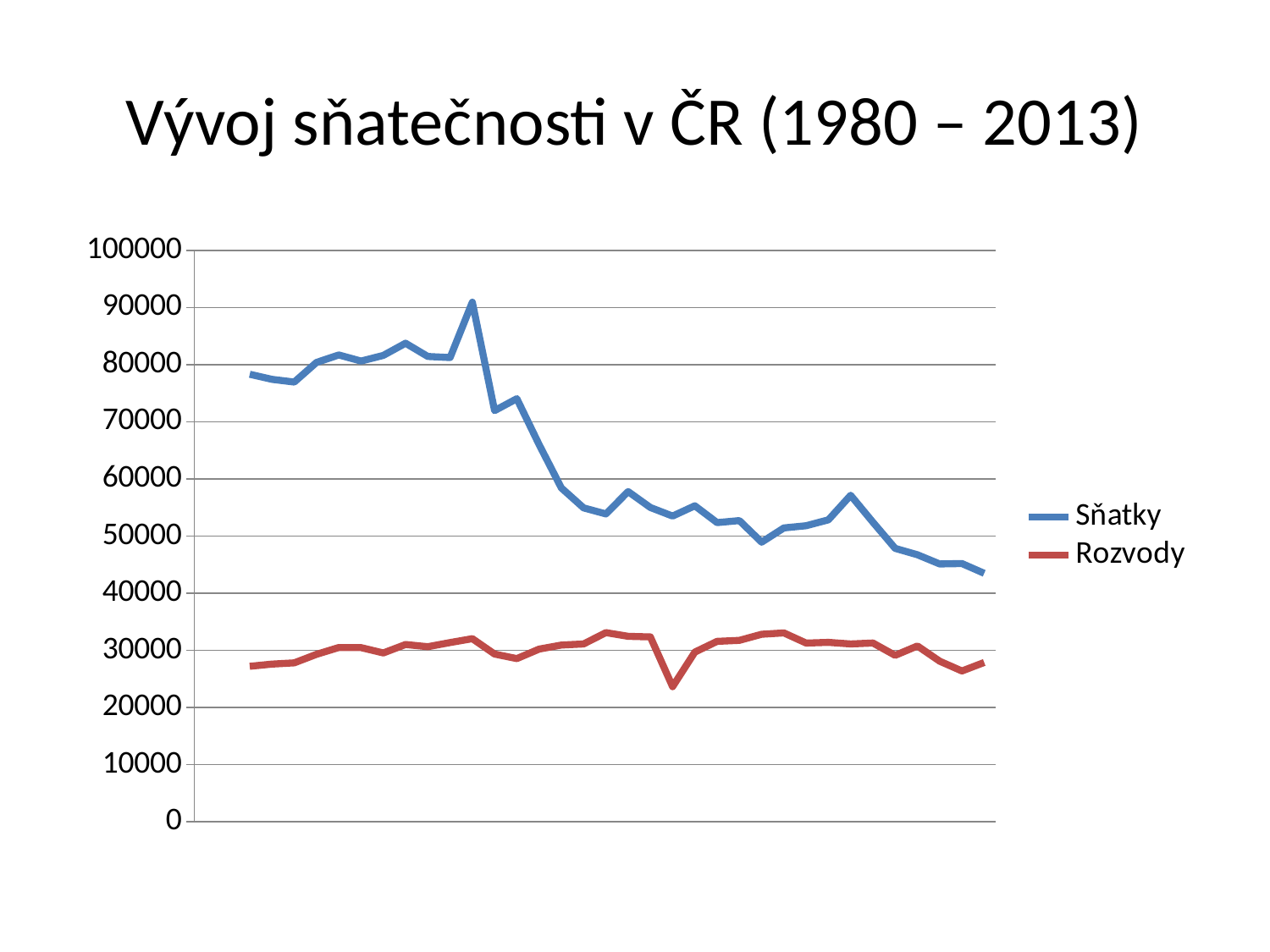
Is the lowest value of the Rozvody series greater or less than 30000? less Is the highest value of the Rozvody series greater or less than 40000? less Which series is drawn in blue? Sňatky Is the highest value of the Sňatky series greater or less than 80000? greater How many series does the legend list? 2 What kind of chart is shown on the slide? line chart Which series has higher values throughout the chart, Sňatky or Rozvody? Sňatky Do the values of the Sňatky series overall rise or fall from left to right? fall What is the title of the chart? Vývoj sňatečnosti v ČR (1980 – 2013)